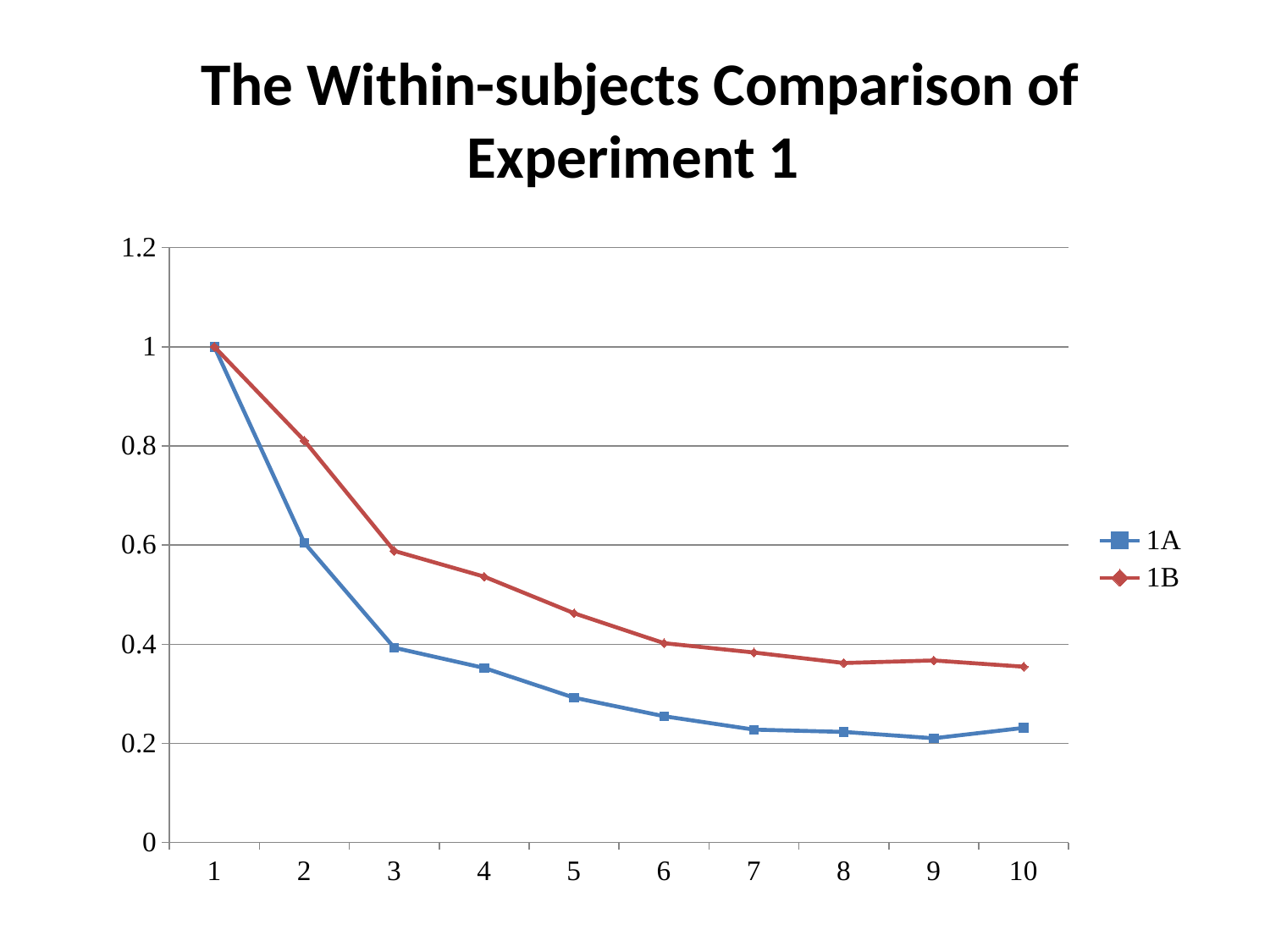
At x = 5, which series has the higher value, 1A or 1B? 1B Do the values of series 1B generally rise or fall as x increases from 1 to 10? fall What is the title of the chart? The Within-subjects Comparison of Experiment 1 At which x value does series 1A reach its highest value? 1 What is the value of series 1A at x = 1? 1 What is the value of series 1B at x = 1? 1 What kind of chart is shown on the slide? line chart How many series does the legend list? 2 Is the value for series 1A at x = 5 greater or less than 0.2? greater Is the value for series 1B at x = 5 greater or less than 0.4? greater Is the value for series 1A at x = 10 greater or less than 0.4? less How many points are plotted along the x axis for each series? 10